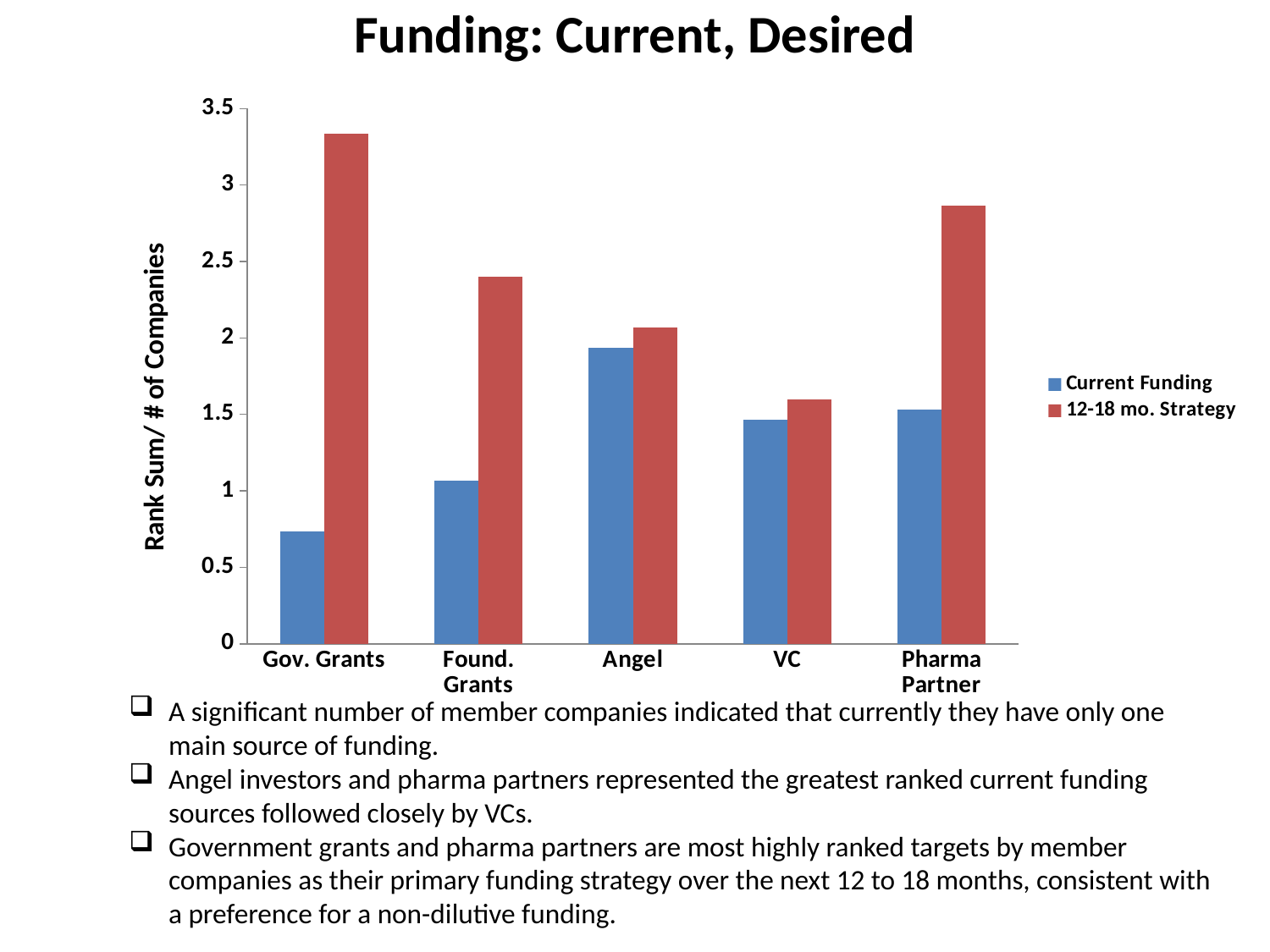
Which category has the highest Current Funding value? Angel Which category has the highest 12-18 mo. Strategy value? Gov. Grants What type of chart is shown on the slide? bar chart How many series does the legend list? 2 What is the label of the y axis? Rank Sum/ # of Companies Is the Current Funding value for Gov. Grants greater or less than 1? less Which is larger for Pharma Partner: the Current Funding value or the 12-18 mo. Strategy value? 12-18 mo. Strategy Is the 12-18 mo. Strategy value for Gov. Grants greater or less than 3? greater Is the Current Funding value for Angel greater or less than 1.5? greater How many funding categories are shown on the x axis? 5 Which category has the lowest 12-18 mo. Strategy value? VC Which category has the lowest Current Funding value? Gov. Grants